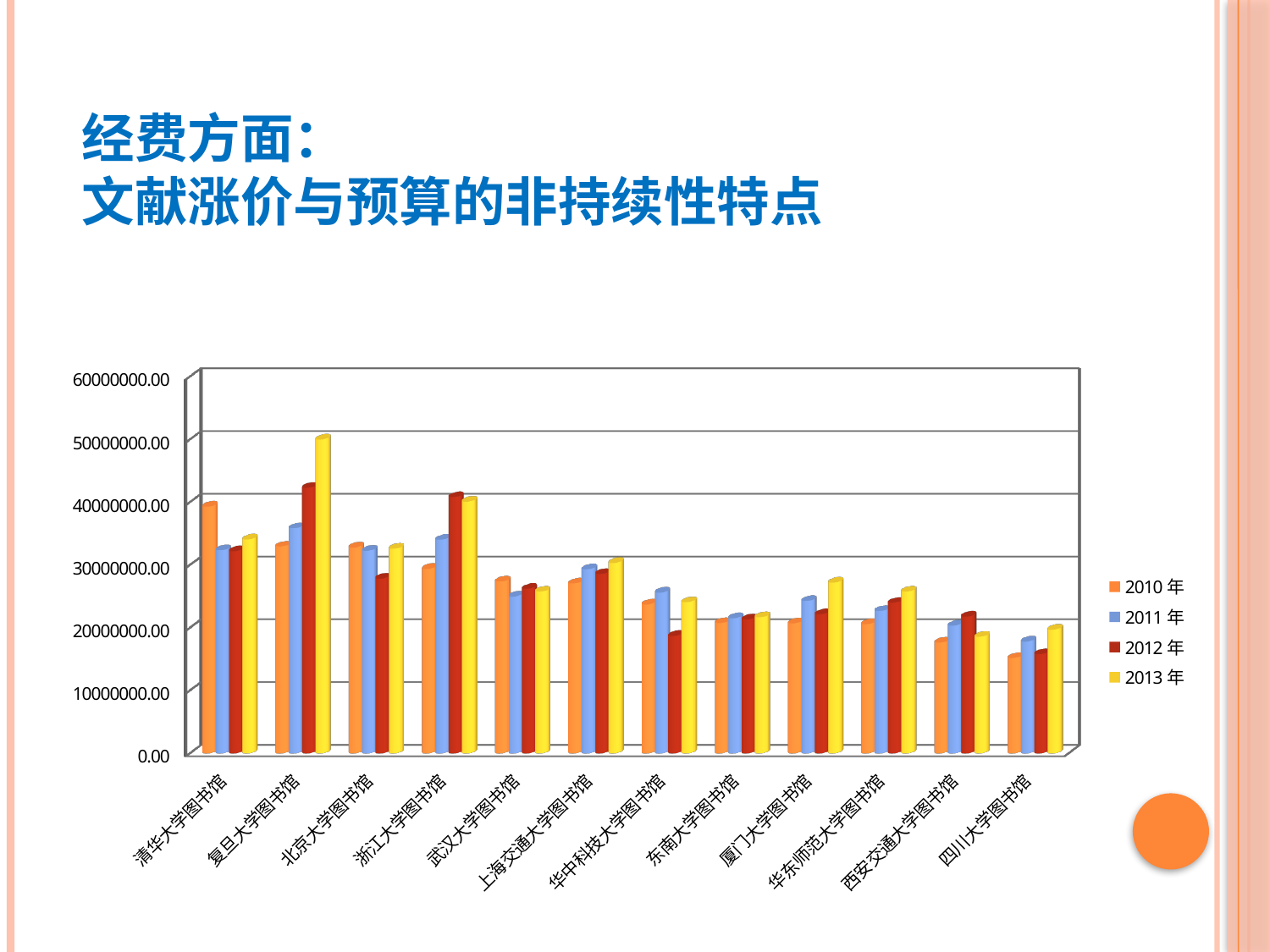
Is the 2013年 value for 复旦大学图书馆 greater or less than 40000000.00? greater Which library has the lowest 2010年 value in the chart? 四川大学图书馆 How many series does the chart's legend list? 4 For 北京大学图书馆, which is larger: the 2011年 value or the 2012年 value? 2011年 Which years are listed in the chart's legend? 2010年, 2011年, 2012年, 2013年 How many libraries (categories) are shown on the x axis of the chart? 12 Which library has the highest 2010年 value in the chart? 清华大学图书馆 Is the 2010年 value for 四川大学图书馆 greater or less than 20000000.00? less For 复旦大学图书馆, do the values rise or fall from 2010年 to 2013年? rise Is the 2013年 value for 厦门大学图书馆 greater or less than 30000000.00? less What kind of chart is shown on the slide? bar chart Which library has the highest 2013年 value in the chart? 复旦大学图书馆